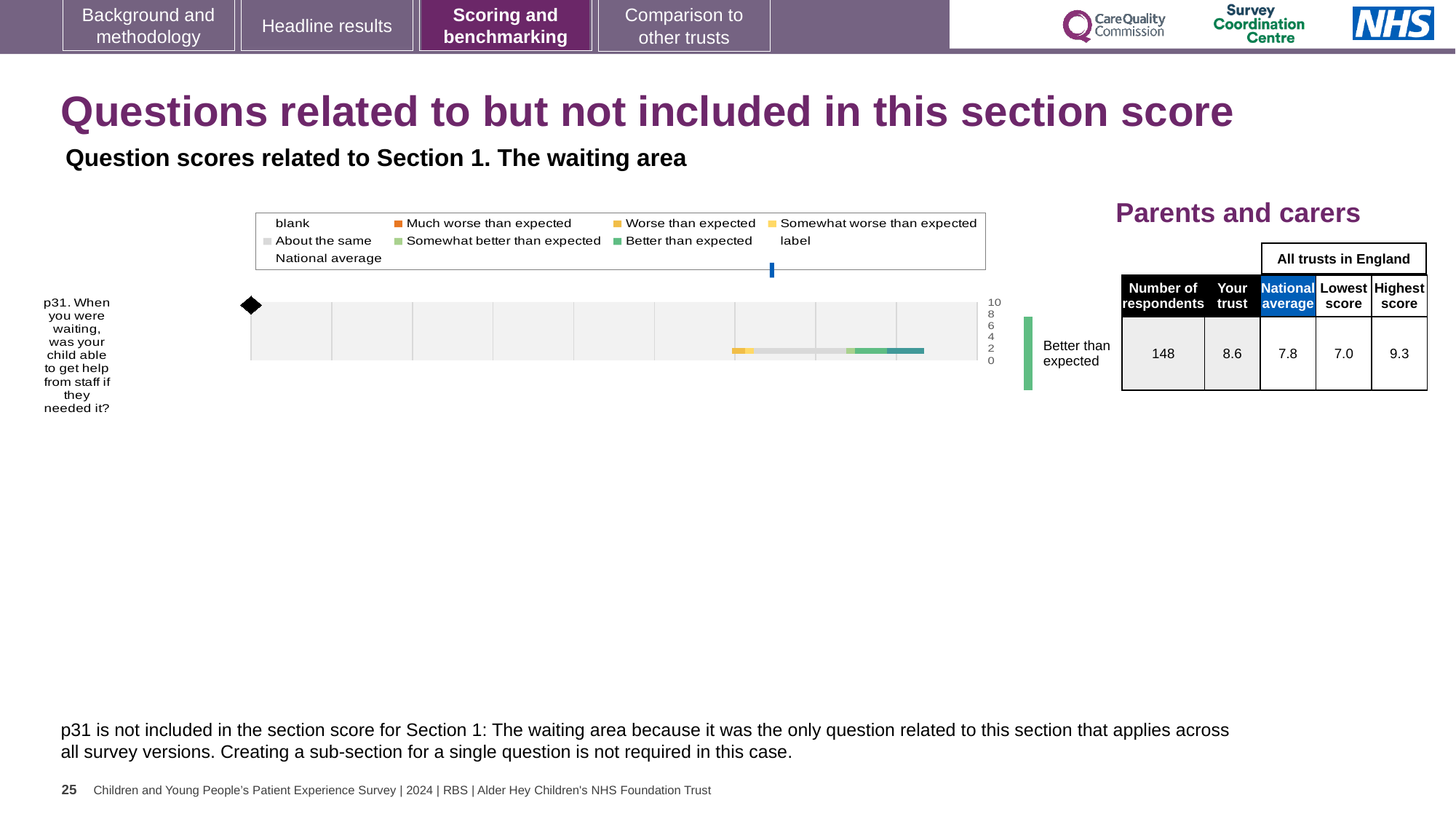
Is the trust's score for question p31 higher or lower than the national average? Higher What is the highest value shown on the chart's axis? 10 How many survey questions are plotted in the chart? 1 How many respondents answered question p31? 148 What rating label is shown to the right of the bar for question p31? Better than expected In the table beside the chart, what is the national average score for question p31? 7.8 In the table beside the chart, what is the 'Your trust' score for question p31? 8.6 In the table beside the chart, what is the lowest score among all trusts in England for question p31? 7.0 Which question is plotted in the chart? p31. When you were waiting, was your child able to get help from staff if they needed it? What is the difference between the trust's score and the national average for question p31? 0.8 In the table beside the chart, what is the highest score among all trusts in England for question p31? 9.3 What kind of chart is used to show the score for question p31? Bar chart